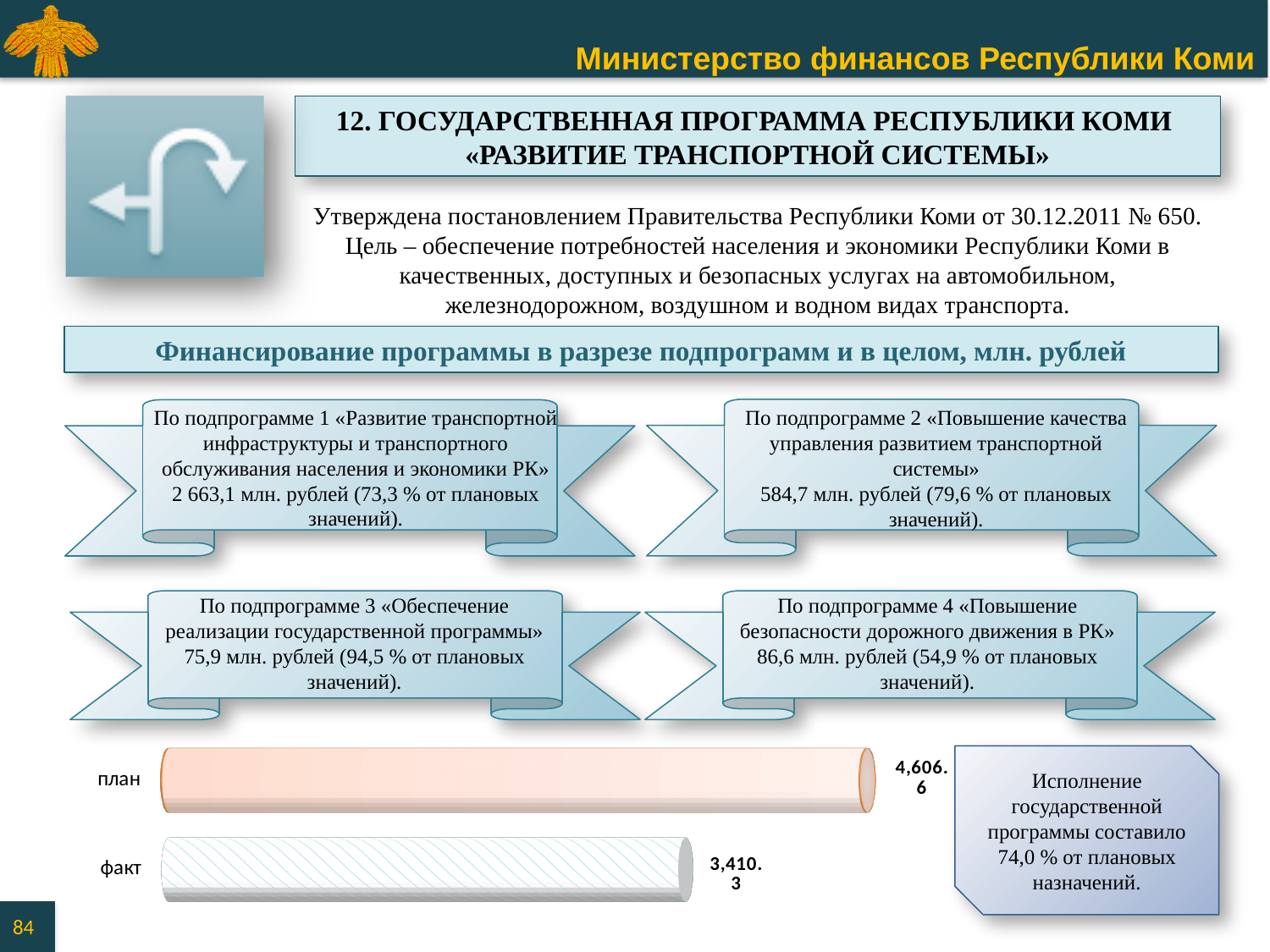
Which category has the smaller bar in the chart, план or факт? факт Which bar in the chart has a hatched (striped) pattern, план or факт? факт What is the difference between the план and факт values shown in the chart? 1,196.3 What kind of chart is shown at the bottom of the slide? bar chart Is the факт value larger or smaller than the план value in the chart? smaller What is the value of the факт bar in the chart at the bottom of the slide? 3,410.3 Are the bars in the chart oriented horizontally or vertically? horizontally Which category has the larger bar in the chart, план or факт? план What is the value of the план bar in the chart at the bottom of the slide? 4,606.6 How many bars are plotted in the chart at the bottom of the slide? 2